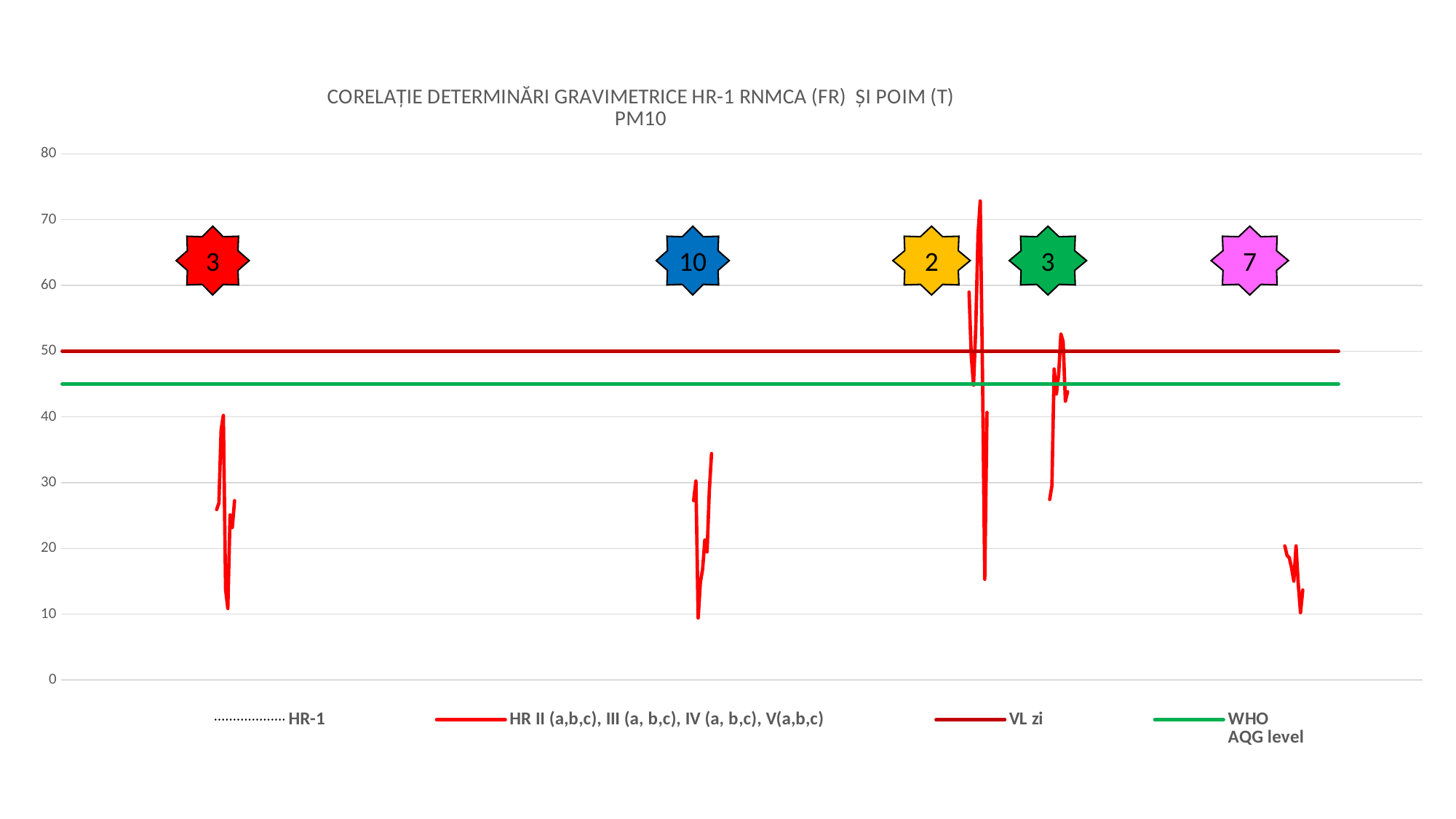
What colour is the WHO AQG level line? green Is the value of the WHO AQG level line greater or less than 40? greater Does the red HR II–V series ever rise above the VL zi line? yes What is the title of the chart? CORELAȚIE DETERMINĂRI GRAVIMETRICE HR-1 RNMCA (FR) ȘI POIM (T) PM10 Is the highest peak of the red HR II–V series greater or less than 70? greater Which is higher on the chart, the VL zi line or the WHO AQG level line? VL zi How many series does the legend list? 4 Is the value of the WHO AQG level line greater or less than 50? less At what value does the VL zi line sit on the y axis? 50 What kind of chart is shown on the slide? line chart